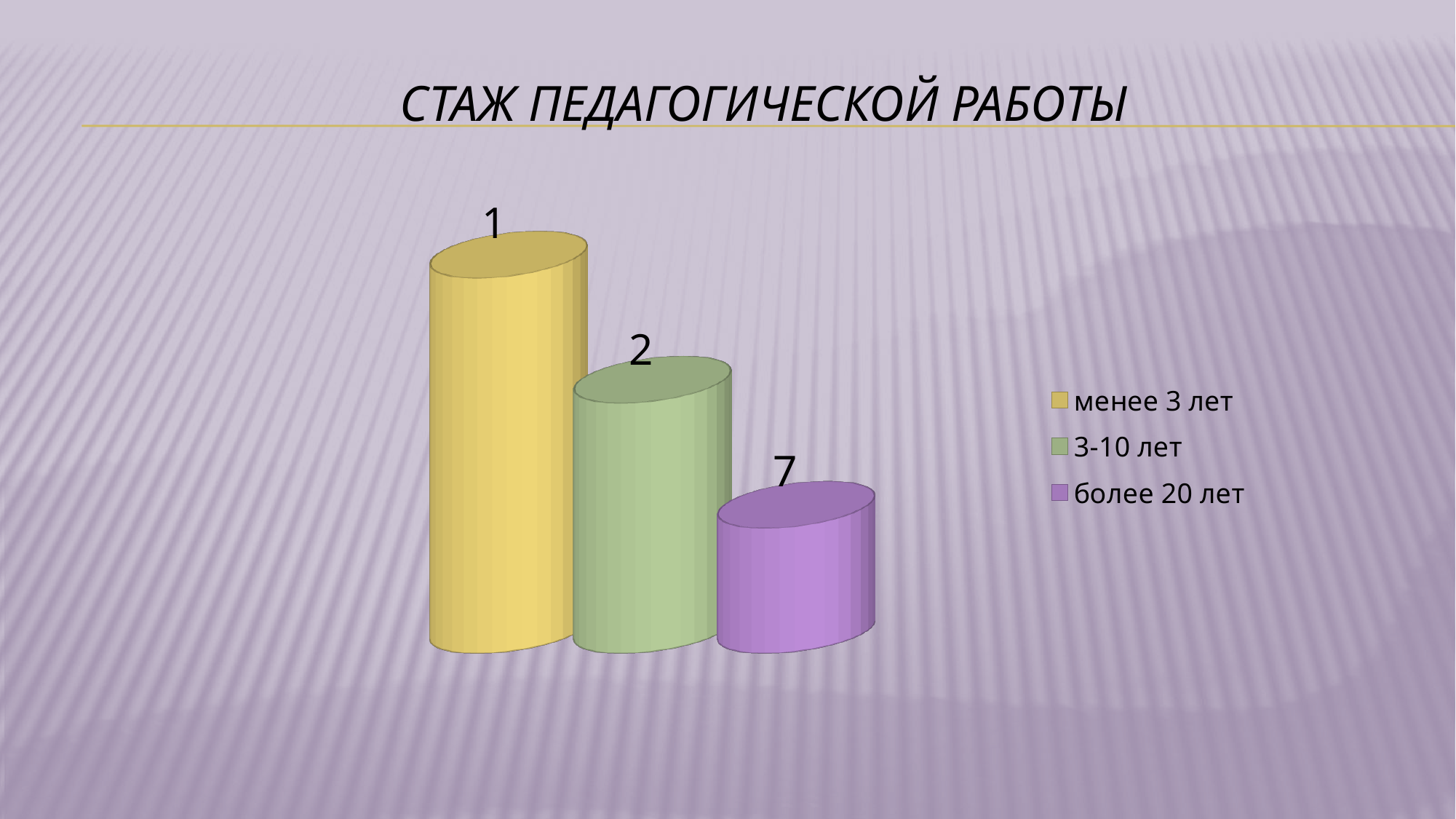
What data label is printed above the bar for 'более 20 лет'? 7 How many bars are shown in the chart? 3 Which legend entry is shown in purple? более 20 лет How many entries does the legend list? 3 What is the title of the slide? СТАЖ ПЕДАГОГИЧЕСКОЙ РАБОТЫ What kind of chart is shown on the slide? bar chart What data label is printed above the bar for '3-10 лет'? 2 What data label is printed above the bar for 'менее 3 лет'? 1